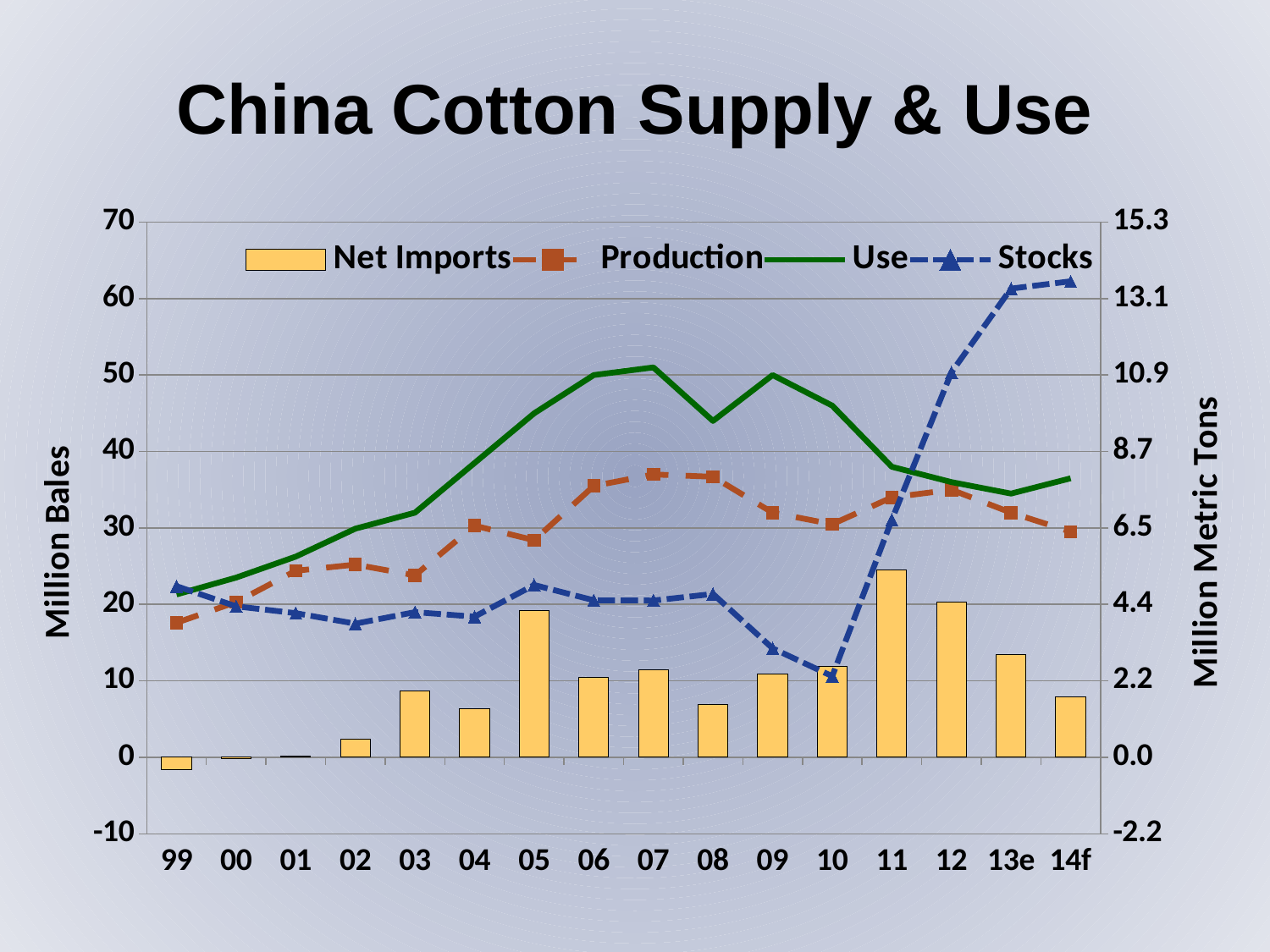
What kind of chart is shown on the slide? A combination bar and line chart Is the Production value for 99 greater or less than 20? less Is the Stocks value for 12 greater or less than 40 on the left axis? greater In which year is the Use line at its lowest? 99 In 07, which is larger, Use or Production? Use How many years are shown along the x axis? 16 How many series does the legend list? 4 What is the label of the right-hand vertical axis? Million Metric Tons In which year is the Stocks line at its lowest? 10 In which year are Net Imports highest? 11 Does the Stocks line rise or fall from 10 to 13e? Rise Is the Net Imports value for 11 greater or less than 20? greater